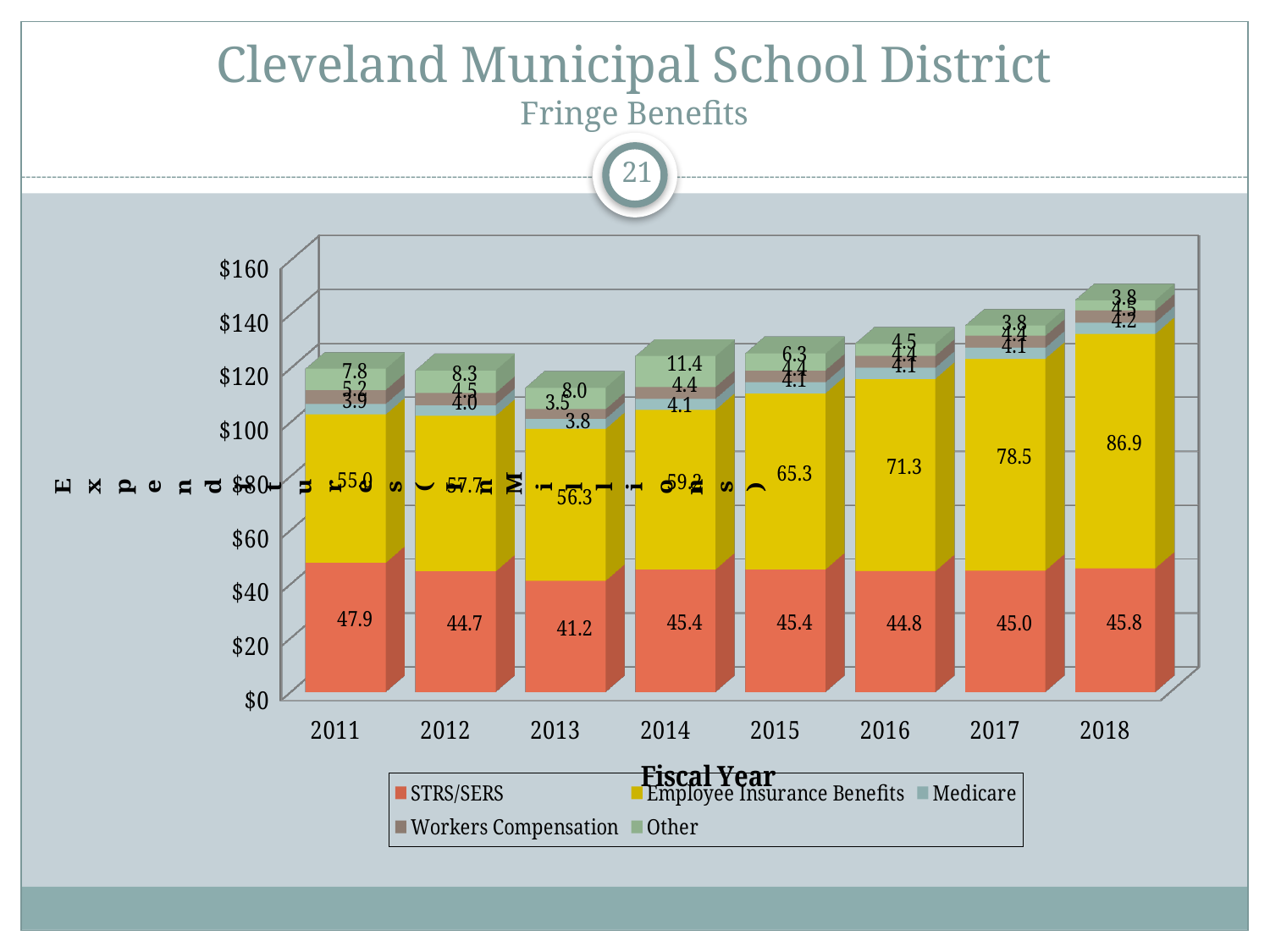
Which fiscal year has the highest Employee Insurance Benefits value? 2018 What is the Medicare value for fiscal year 2013? 3.8 Do the Employee Insurance Benefits values rise or fall from 2015 to 2018? rise What is the Employee Insurance Benefits value for fiscal year 2018? 86.9 How many fiscal years are shown on the x axis? 8 Which fiscal year has the lowest STRS/SERS value? 2013 What is the Other value for fiscal year 2014? 11.4 What is the STRS/SERS value for fiscal year 2011? 47.9 What is the difference between the Employee Insurance Benefits values for 2018 and 2017? 8.4 How many series does the legend list? 5 Which is larger, the Other value for 2014 or for 2015? 2014 Is the total height of the 2018 bar greater or less than $140? greater